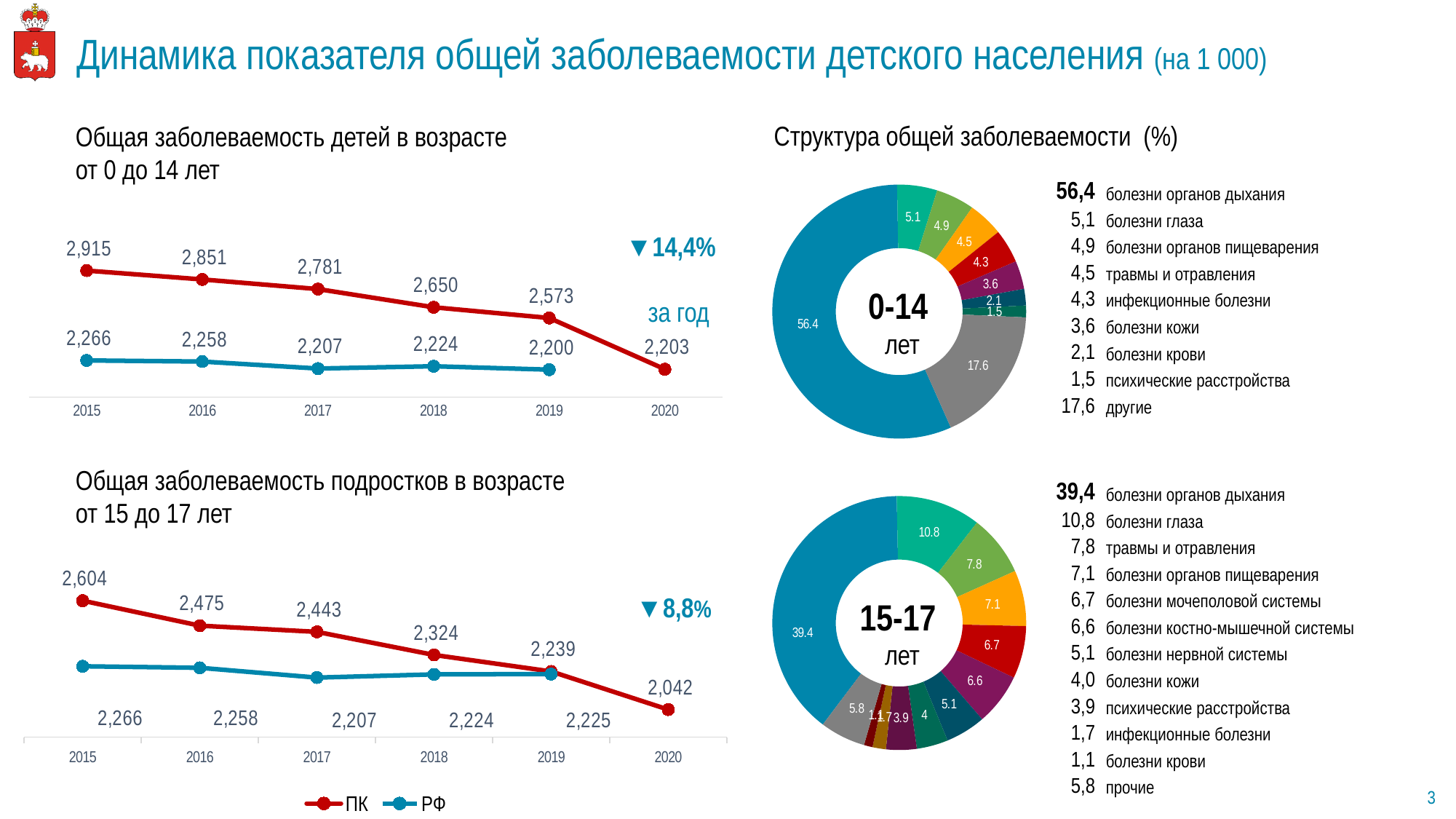
On the line chart 'Общая заболеваемость детей в возрасте от 0 до 14 лет', what is the difference between the ПК values for 2019 and 2020? 370 On the line chart 'Общая заболеваемость детей в возрасте от 0 до 14 лет', what is the РФ value for 2018? 2,224 On the line chart 'Общая заболеваемость детей в возрасте от 0 до 14 лет', what is the ПК value for 2015? 2,915 On the donut chart for 0-14 лет, what share is 'болезни органов дыхания'? 56,4 On the line chart 'Общая заболеваемость подростков в возрасте от 15 до 17 лет', in which year is the ПК value highest? 2015 On the line chart 'Общая заболеваемость детей в возрасте от 0 до 14 лет', does the ПК series rise or fall from 2015 to 2020? fall On the donut chart for 15-17 лет, what is the value for 'болезни глаза'? 10,8 On the line chart 'Общая заболеваемость подростков в возрасте от 15 до 17 лет', which is larger in 2016: the ПК value or the РФ value? ПК How many categories does the donut chart for 15-17 лет show? 12 On the line chart 'Общая заболеваемость подростков в возрасте от 15 до 17 лет', what is the ПК value for 2020? 2,042 What type of chart is used for 'Общая заболеваемость детей в возрасте от 0 до 14 лет'? line chart How many series does the legend at the bottom of the slide list? 2